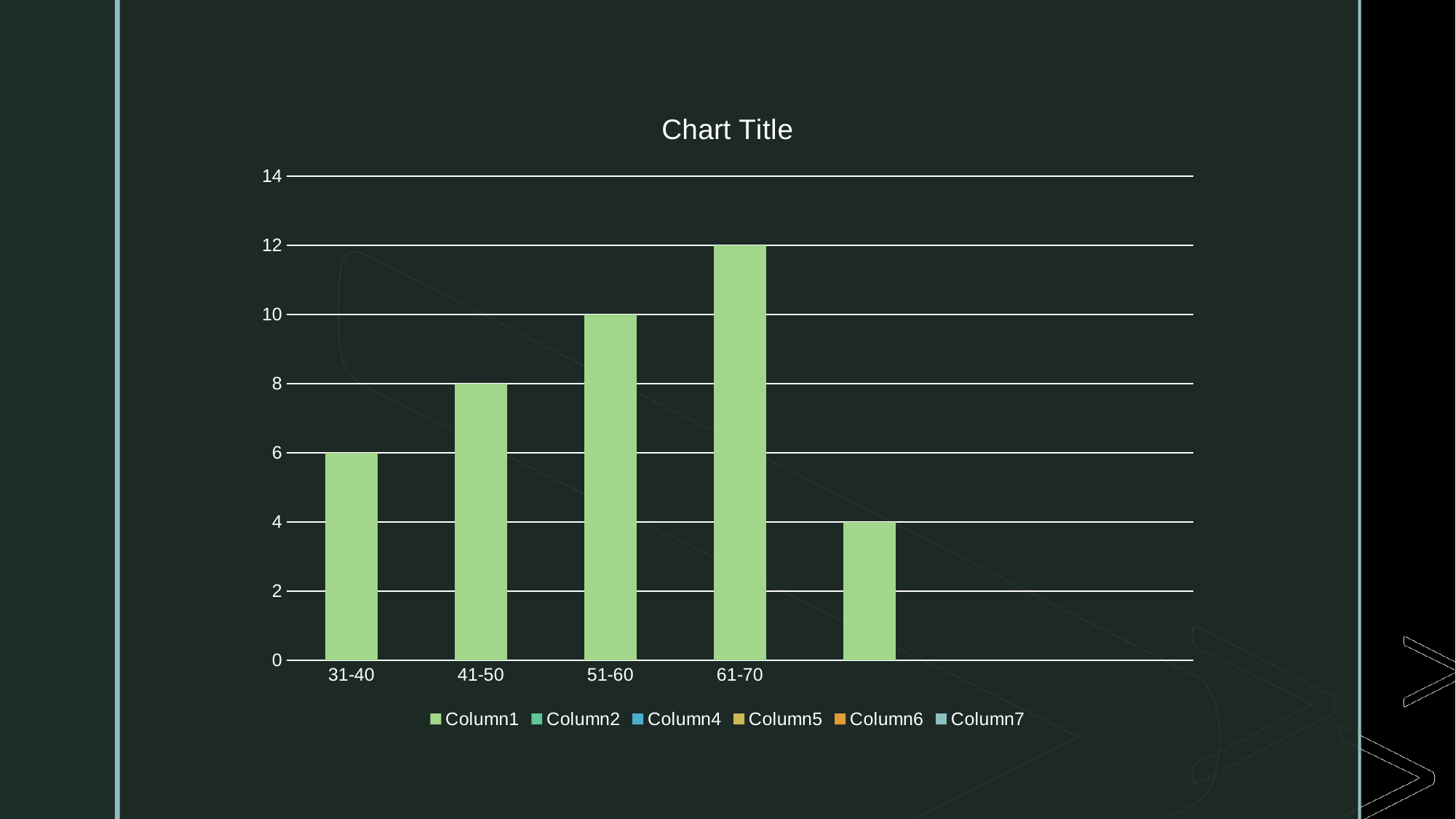
What is the value for the 31-40 category? 6 What is the value for the 51-60 category? 10 How many series does the legend list? 6 Which is larger, the value for 41-50 or the value for 51-60? 51-60 What is the difference between the values for 61-70 and 31-40? 6 What is the value for the 61-70 category? 12 What is the value for the 41-50 category? 8 What kind of chart is shown on the slide? bar chart Which labeled category has the highest value? 61-70 Is the value for 31-40 greater or less than 8? less Do the values rise or fall from 31-40 to 61-70? rise How many bars are plotted on the chart? 5